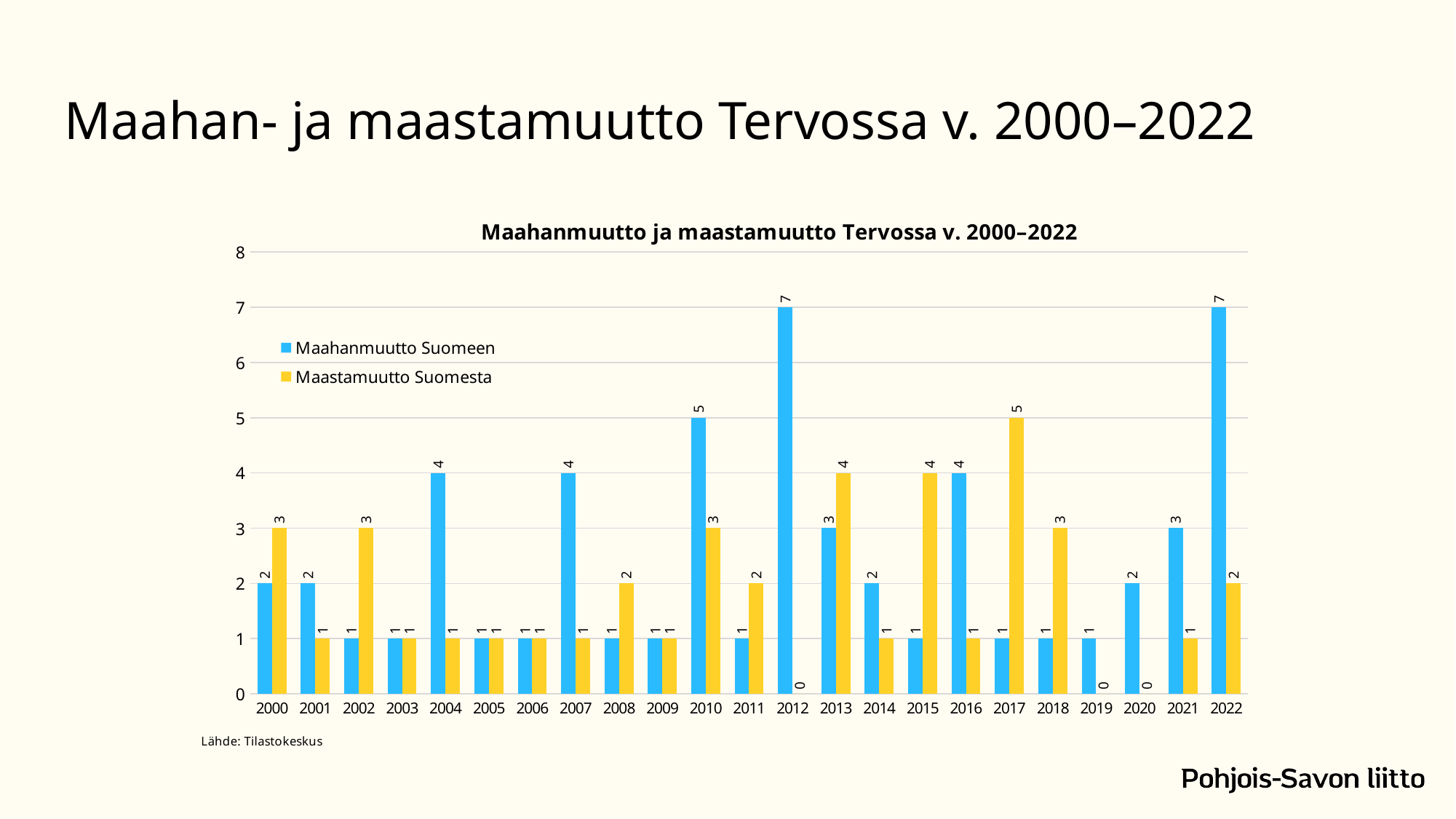
What is the difference between Maahanmuutto Suomeen and Maastamuutto Suomesta in 2022? 5 What is the value of Maahanmuutto Suomeen in 2012? 7 What is the difference between Maastamuutto Suomesta and Maahanmuutto Suomeen in 2015? 3 In which year is Maastamuutto Suomesta highest? 2017 What is the value of Maastamuutto Suomesta in 2017? 5 How many series does the legend list? 2 What is the value of Maastamuutto Suomesta in 2020? 0 What kind of chart is shown on the slide? Bar chart In 2013, which is larger: Maahanmuutto Suomeen or Maastamuutto Suomesta? Maastamuutto Suomesta What is the title of the chart? Maahanmuutto ja maastamuutto Tervossa v. 2000–2022 What is the value of Maahanmuutto Suomeen in 2010? 5 How many years are shown on the x axis? 23